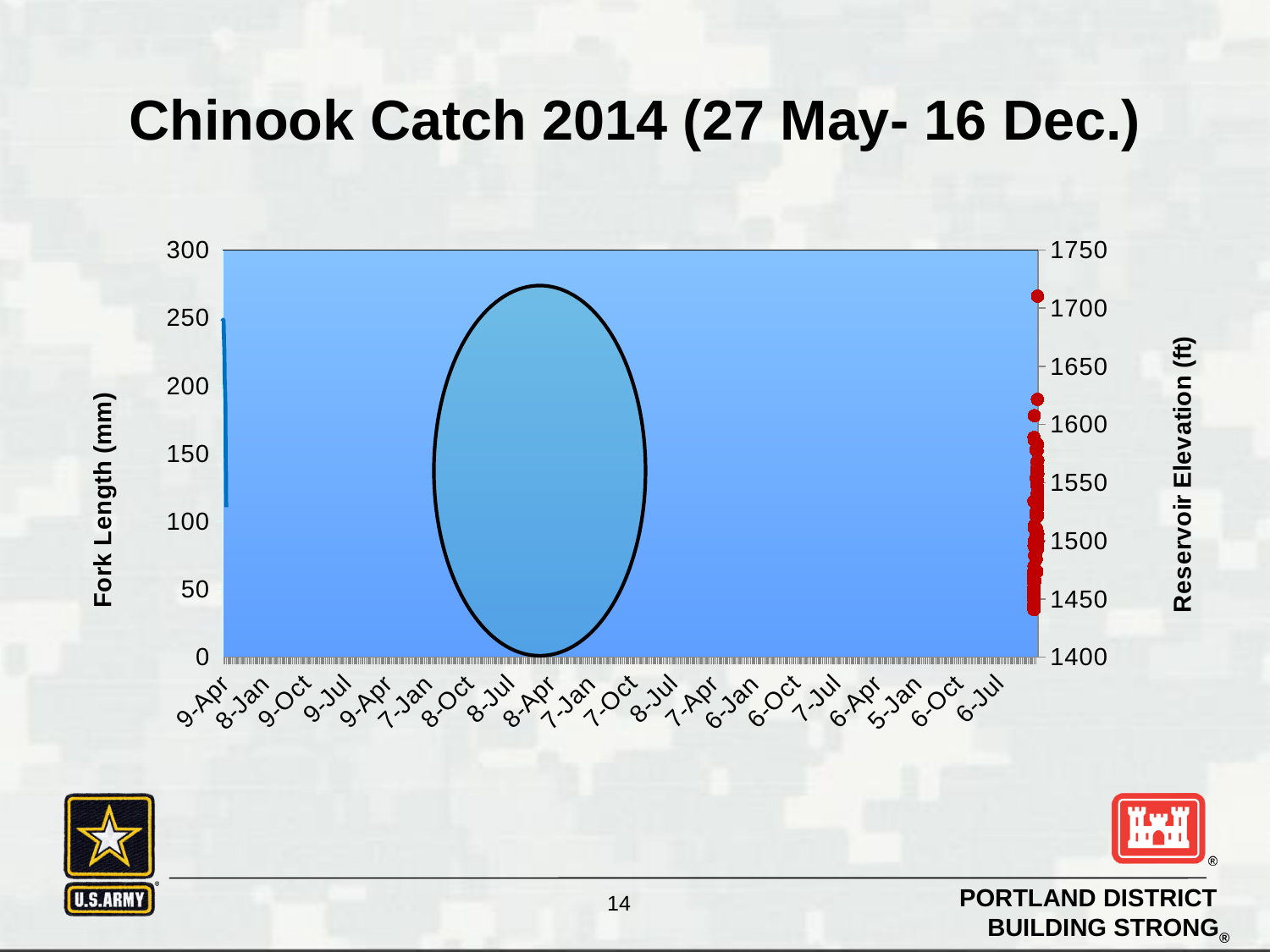
What is the title of the chart? Chinook Catch 2014 (27 May- 16 Dec.) What is the maximum value shown on the Fork Length (mm) axis? 300 What colour are the points plotted against the Reservoir Elevation (ft) axis? red Is the top of the blue line on the Fork Length (mm) axis greater or less than 200? greater Is the lowest red point on the Reservoir Elevation (ft) axis greater or less than 1500? less Is the highest red point on the Reservoir Elevation (ft) axis greater or less than 1650? greater